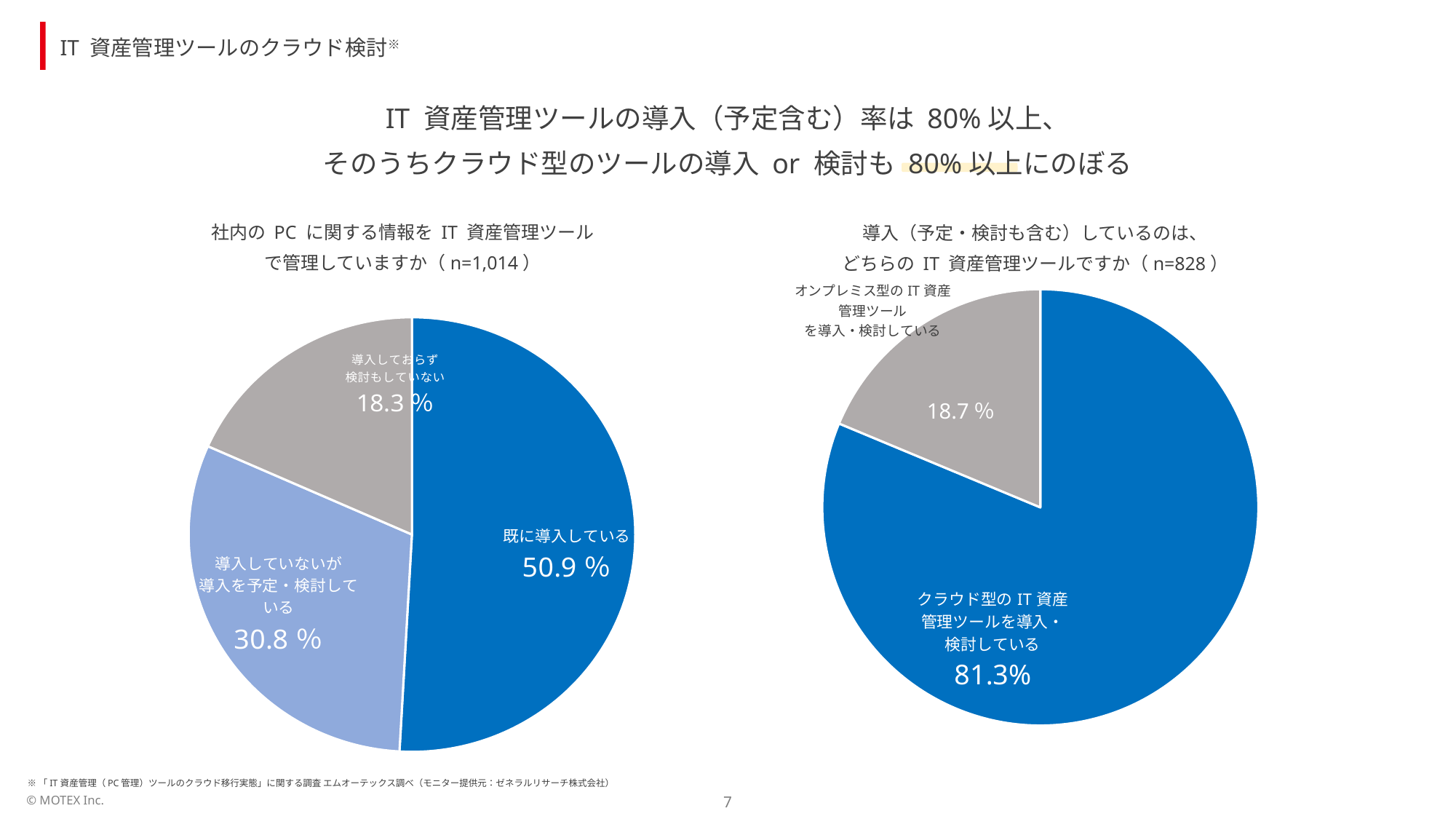
In the left pie chart, what share of respondents answered 既に導入している? 50.9 % In the left pie chart, what share of respondents answered 導入していないが導入を予定・検討している? 30.8 % In the right pie chart, what share of respondents are adopting or considering a cloud-type IT asset management tool (クラウド型)? 81.3% How many slices does the left pie chart have? 3 In the left pie chart, which category has the smallest share? 導入しておらず検討もしていない In the left pie chart, what share of respondents answered 導入しておらず検討もしていない? 18.3 % In the left pie chart, what is the difference in percentage points between 既に導入している and 導入していないが導入を予定・検討している? 20.1 What type of chart is used on the right side of the slide? Pie chart In the right pie chart, what share of respondents are adopting or considering an on-premises IT asset management tool (オンプレミス型)? 18.7 % In the right pie chart, which is larger: the cloud-type (クラウド型) slice or the on-premises (オンプレミス型) slice? クラウド型 What is the sample size (n) shown in the title of the right pie chart? n=828 In the left pie chart, which category has the largest share? 既に導入している